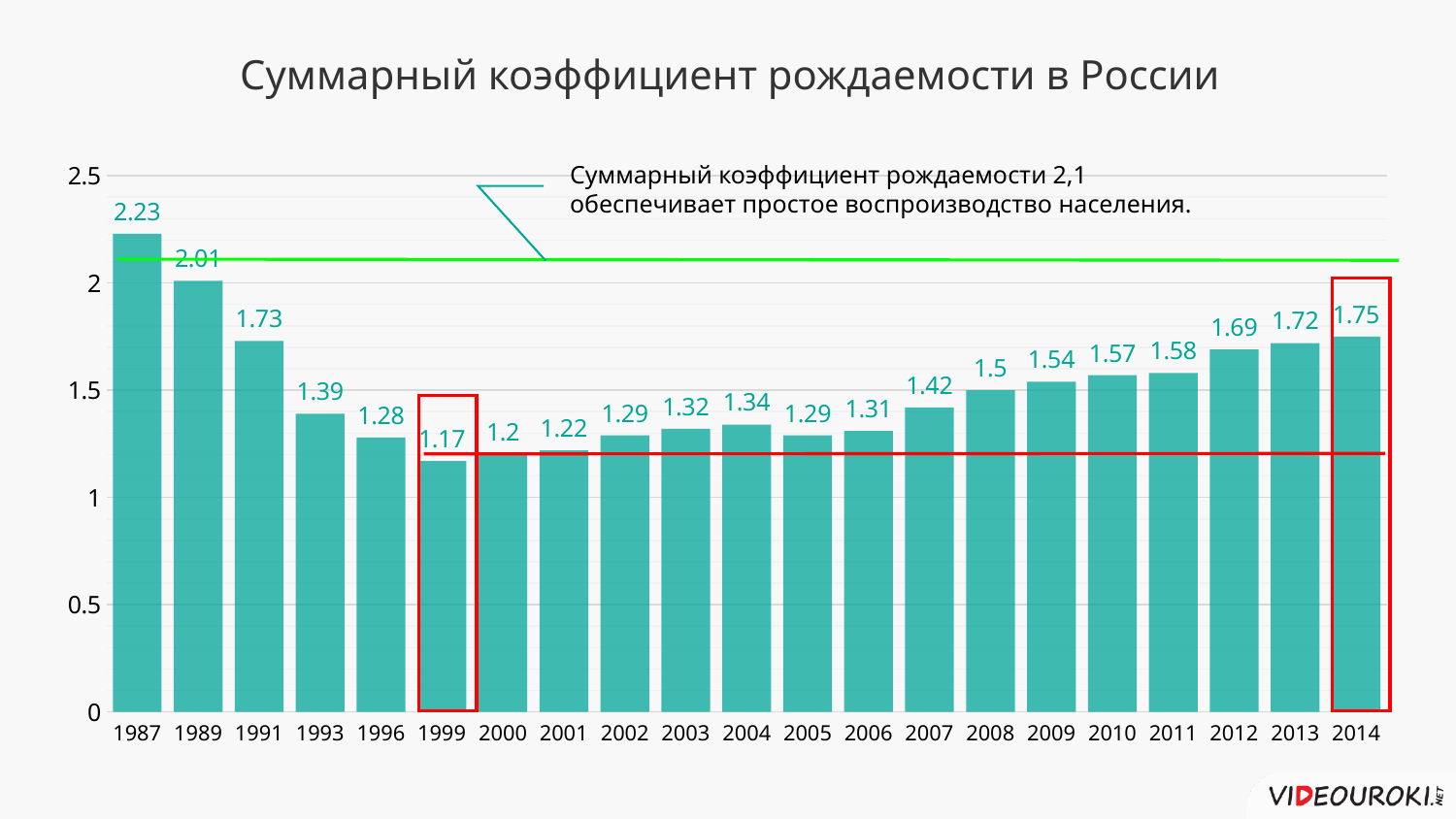
What is the title of the chart? Суммарный коэффициент рождаемости в России How many years are shown on the x axis? 21 What is the difference between the values for 1987 and 1999? 1.06 What kind of chart is shown on the slide? bar chart What value is shown for 2008? 1.5 What is the total fertility rate shown for 1987? 2.23 Which year has the highest value on the chart? 1987 Is the value for 2012 greater or less than 1.5? greater What value is shown for 2014? 1.75 Which year has the lowest value on the chart? 1999 What is the difference between the values for 2014 and 2000? 0.55 Which is larger, the value for 2004 or the value for 2005? 2004